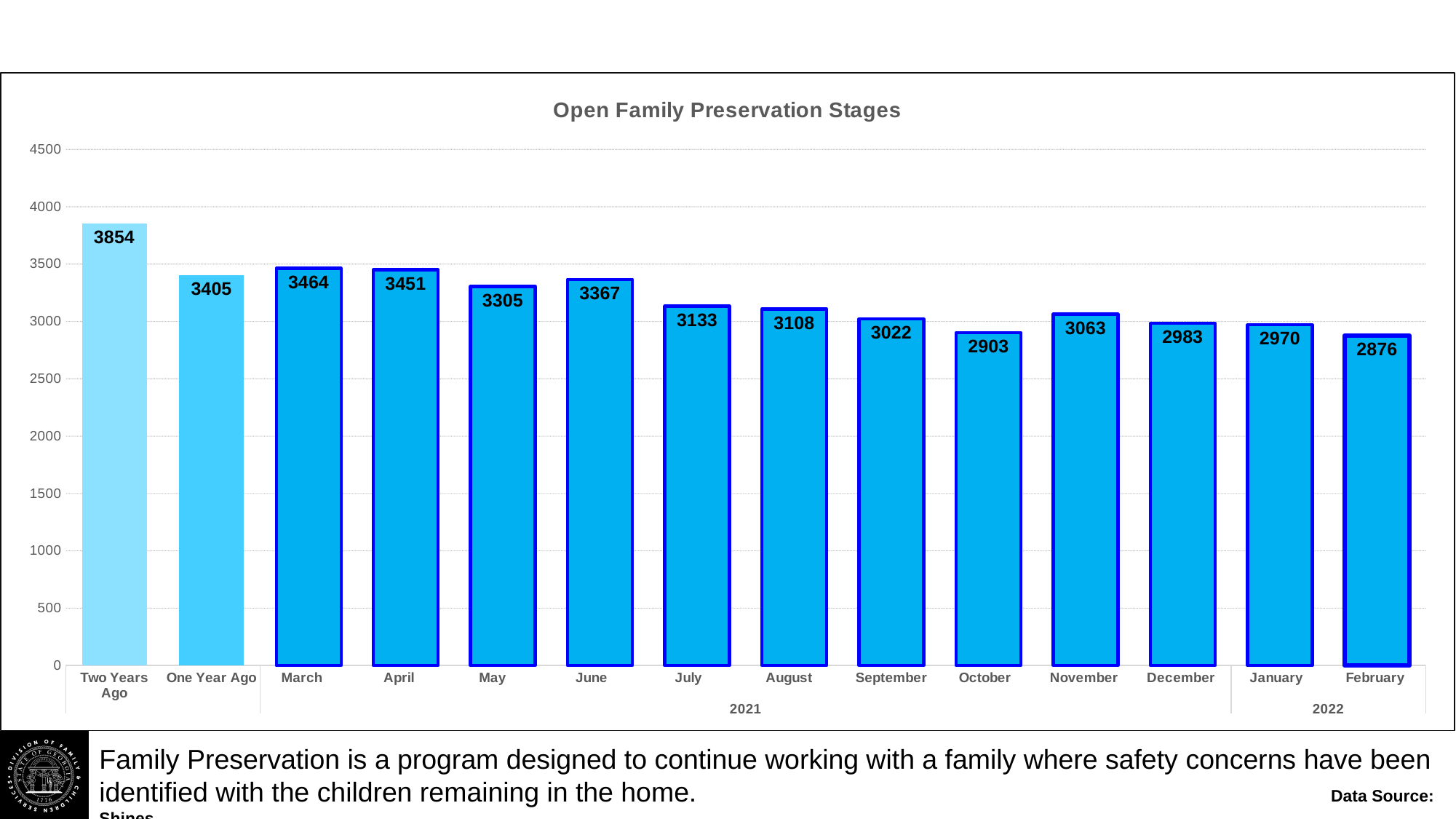
What is the title of the chart? Open Family Preservation Stages How many bars are shown in the chart? 14 What kind of chart is shown on the slide? Bar chart Which category has the lowest value? February What is the value for February 2022? 2876 Which category has the highest value? Two Years Ago What is the value for Two Years Ago? 3854 What is the difference between the values for March and April? 13 Is the value for November greater or less than 3000? greater What is the difference between the values for Two Years Ago and One Year Ago? 449 Which is larger, the value for June or the value for May? June What is the value for October 2021? 2903